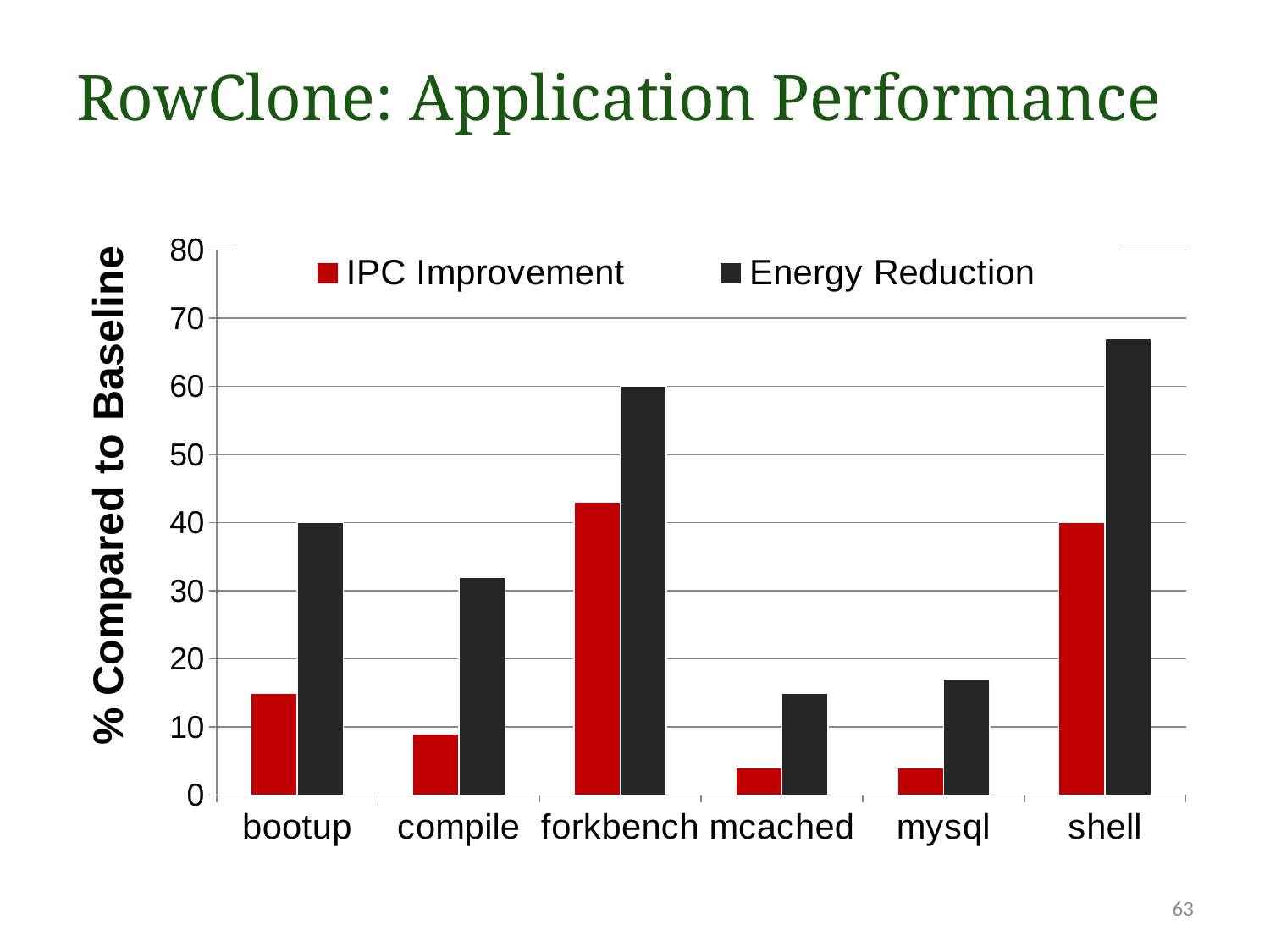
Which is larger for compile, IPC Improvement or Energy Reduction? Energy Reduction Is the Energy Reduction for shell greater or less than 60? greater Which application has the highest IPC Improvement? forkbench How many series does the legend list? 2 How many application categories are shown on the x axis? 6 Which application has the highest Energy Reduction? shell Is the Energy Reduction for mysql greater or less than 20? less What kind of chart is shown on the slide? bar chart What is the label of the y axis? % Compared to Baseline Is the IPC Improvement for mcached greater or less than 10? less Which is larger, the IPC Improvement for forkbench or the IPC Improvement for bootup? forkbench